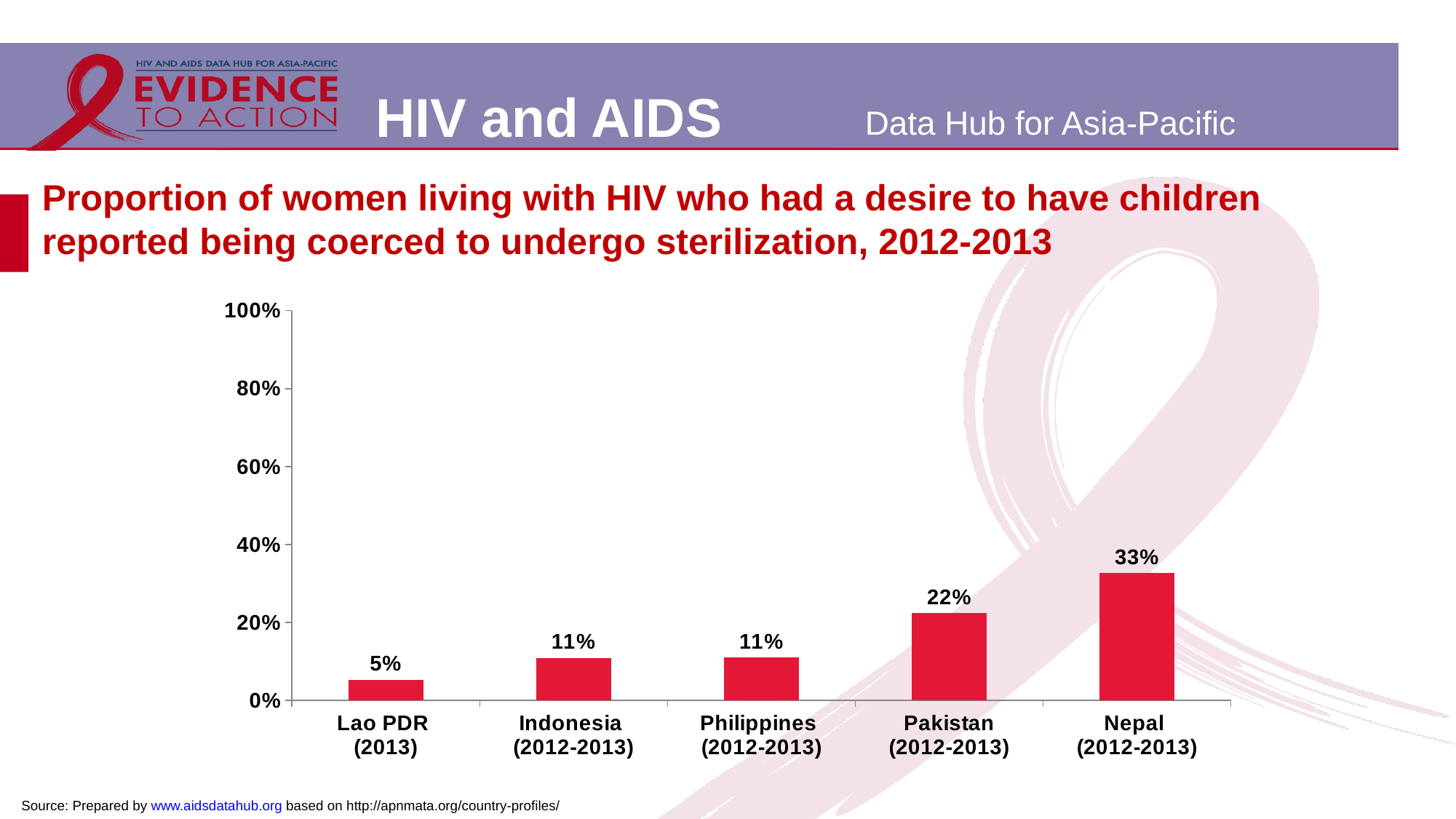
What is the value for Nepal (2012-2013)? 33% What is the value for Lao PDR (2013)? 5% Which country has the lowest proportion? Lao PDR (2013) What is the value for Pakistan (2012-2013)? 22% Which is larger, the value for Pakistan or the value for Philippines? Pakistan How many countries are shown on the chart? 5 What is the difference between the values for Pakistan and Lao PDR? 17% What kind of chart is shown on the slide? bar chart What is the difference between the values for Nepal and Pakistan? 11% Is the value for Nepal greater or less than 40%? less Which country has the highest proportion? Nepal (2012-2013) What is the value for Indonesia (2012-2013)? 11%